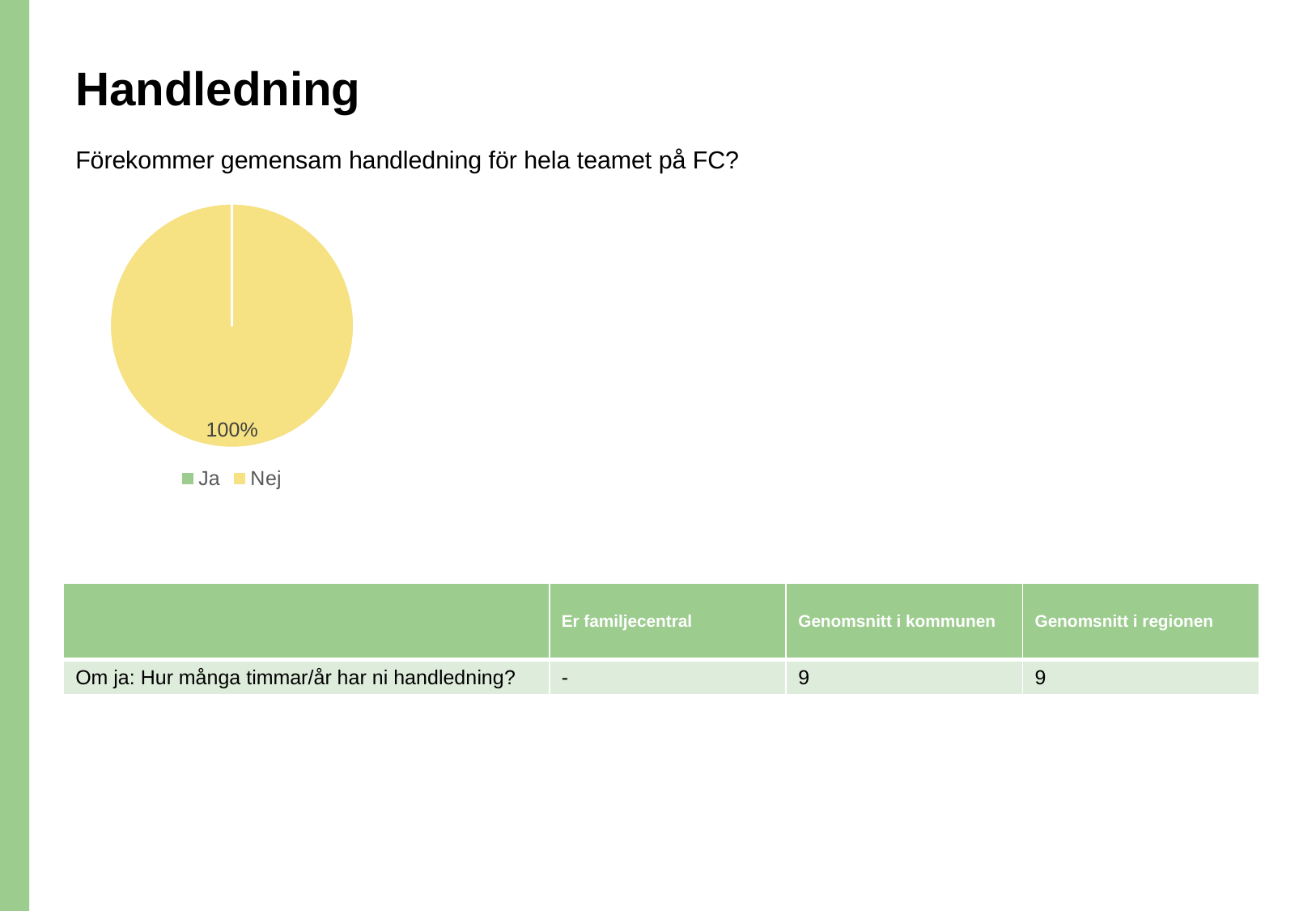
What value is printed on the pie chart? 100% Which category has the largest share of the pie chart? Nej What kind of chart is shown on the slide? pie chart How many entries does the legend of the pie chart list? 2 What share of the pie chart does the Nej slice represent? 100% Which of the two categories, Ja or Nej, has the larger share of the pie chart? Nej What colour is the Nej slice in the pie chart? yellow What question is the pie chart answering, as written above it? Förekommer gemensam handledning för hela teamet på FC? Is the share for Nej greater or less than 50%? greater